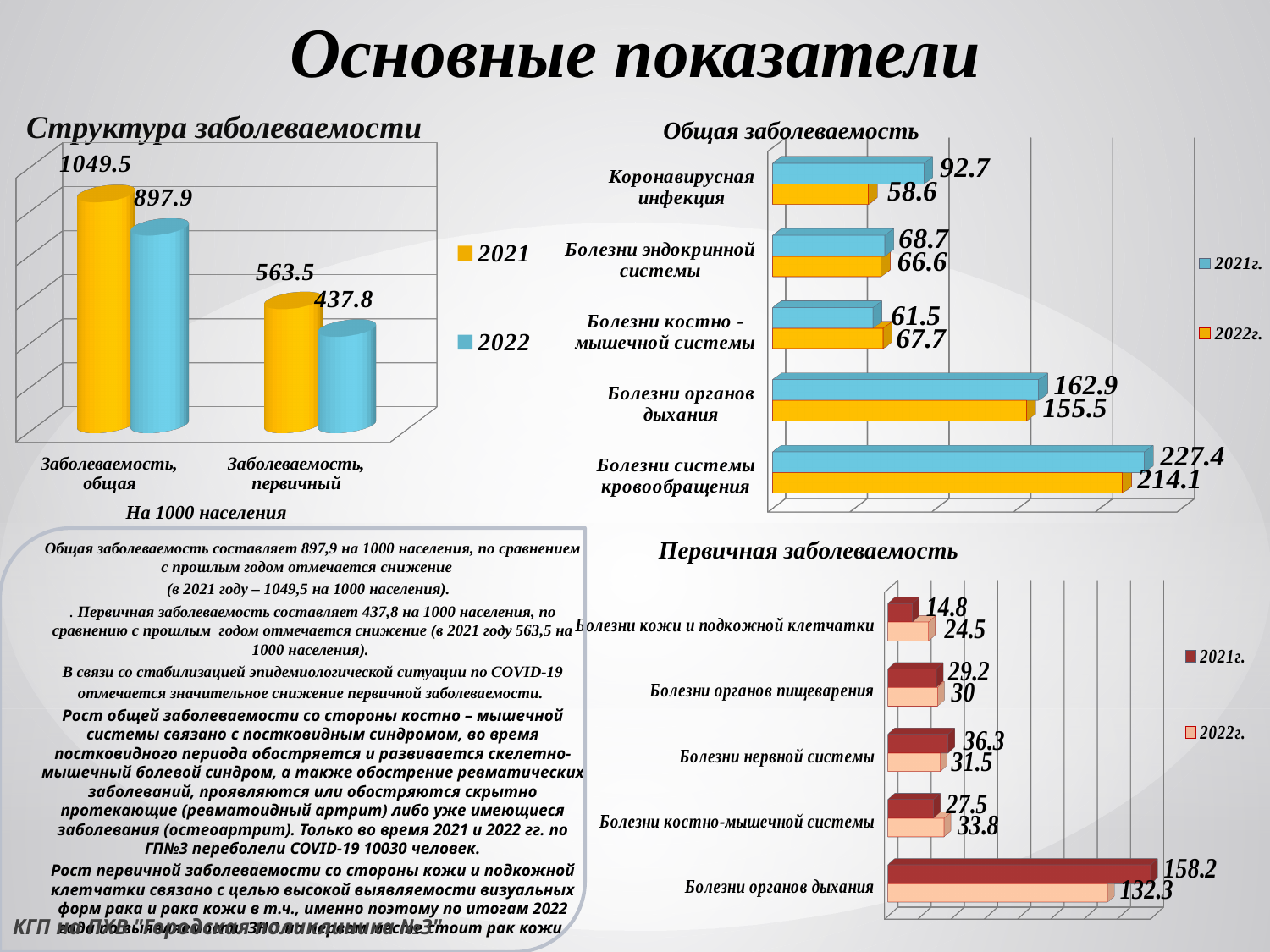
In the 'Структура заболеваемости' chart, what is the difference between the 2021 and 2022 values for 'Заболеваемость, общая'? 151.6 In the 'Общая заболеваемость' chart, which category has the highest 2021г. value? Болезни системы кровообращения In the 'Первичная заболеваемость' chart, what is the difference between the 2022г. and 2021г. values for 'Болезни кожи и подкожной клетчатки'? 9.7 What type of chart is the 'Первичная заболеваемость' chart? bar chart How many categories are shown in the 'Общая заболеваемость' chart? 5 In the 'Структура заболеваемости' chart, what is the value for 'Заболеваемость, первичный' in 2022? 437.8 How many series does the legend of the 'Структура заболеваемости' chart list? 2 In the 'Общая заболеваемость' chart, which category has the lowest 2022г. value? Коронавирусная инфекция In the 'Первичная заболеваемость' chart, what is the 2021г. value for 'Болезни органов дыхания'? 158.2 In the 'Общая заболеваемость' chart, what is the 2022г. value for 'Болезни системы кровообращения'? 214.1 In the 'Структура заболеваемости' chart, what is the value for 'Заболеваемость, общая' in 2021? 1049.5 In the 'Общая заболеваемость' chart, is the 2021г. value for 'Болезни костно-мышечной системы' larger or smaller than the 2022г. value? smaller